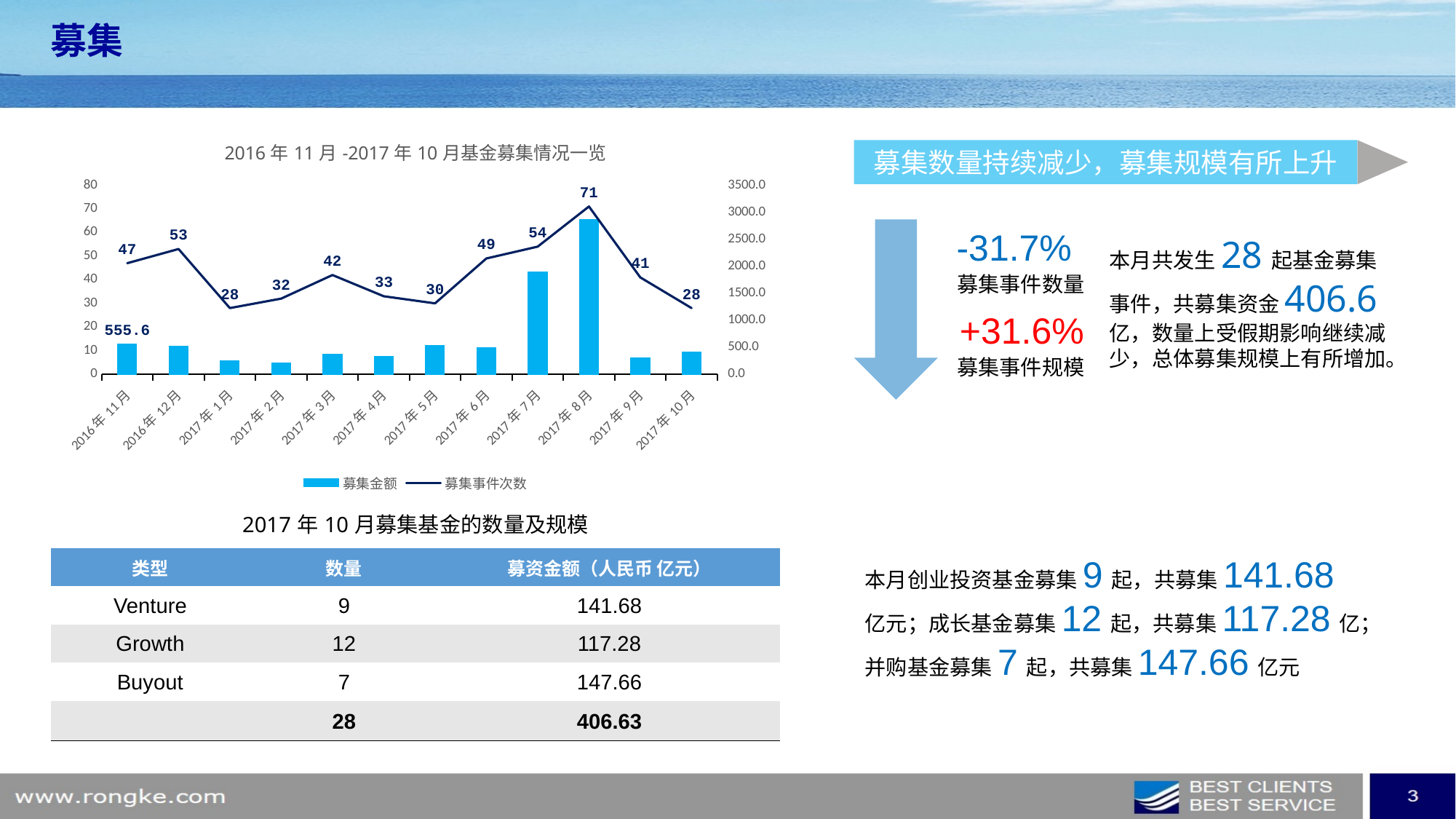
Is the 募集金额 value for 2017年7月 greater or less than 1500.0? greater What is the 募集事件次数 value for 2016年11月? 47 Does the 募集事件次数 line rise or fall from 2017年8月 to 2017年10月? fall What is the 募集金额 data label shown for 2016年11月? 555.6 What is the 募集事件次数 value for 2017年8月? 71 How many months are shown on the x axis of the chart? 12 What kind of chart is shown on the slide? Combined bar and line chart Which month has the highest 募集事件次数? 2017年8月 Which has a higher 募集事件次数, 2017年3月 or 2017年4月? 2017年3月 What is the difference in 募集事件次数 between 2017年8月 and 2017年9月? 30 Is the 募集金额 value for 2017年8月 greater or less than 2500.0? greater How many series does the chart legend list? 2